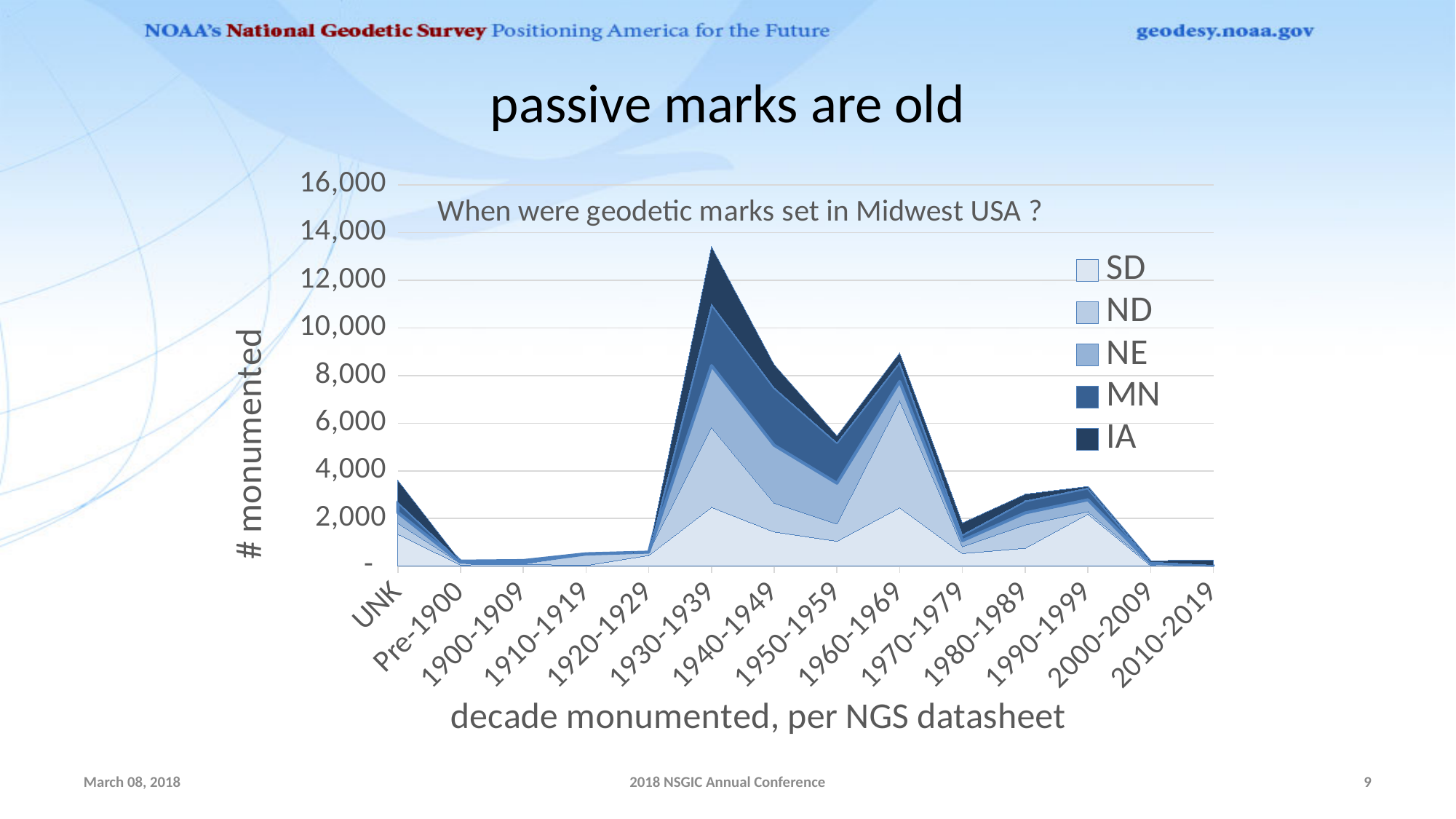
Is the total value for 1960-1969 greater or less than 8,000? greater What is the label of the x axis? decade monumented, per NGS datasheet Which has a larger total, 1990-1999 or 2000-2009? 1990-1999 Is the total value for 2010-2019 greater or less than 2,000? less How many series does the legend list? 5 Is the total value for 1930-1939 greater or less than 12,000? greater What kind of chart is shown on the slide? stacked area chart Which has a larger total, 1930-1939 or 1960-1969? 1930-1939 What is the title of the chart? When were geodetic marks set in Midwest USA ? How many decade categories are shown along the x axis? 14 Which decade has the highest total number of marks monumented? 1930-1939